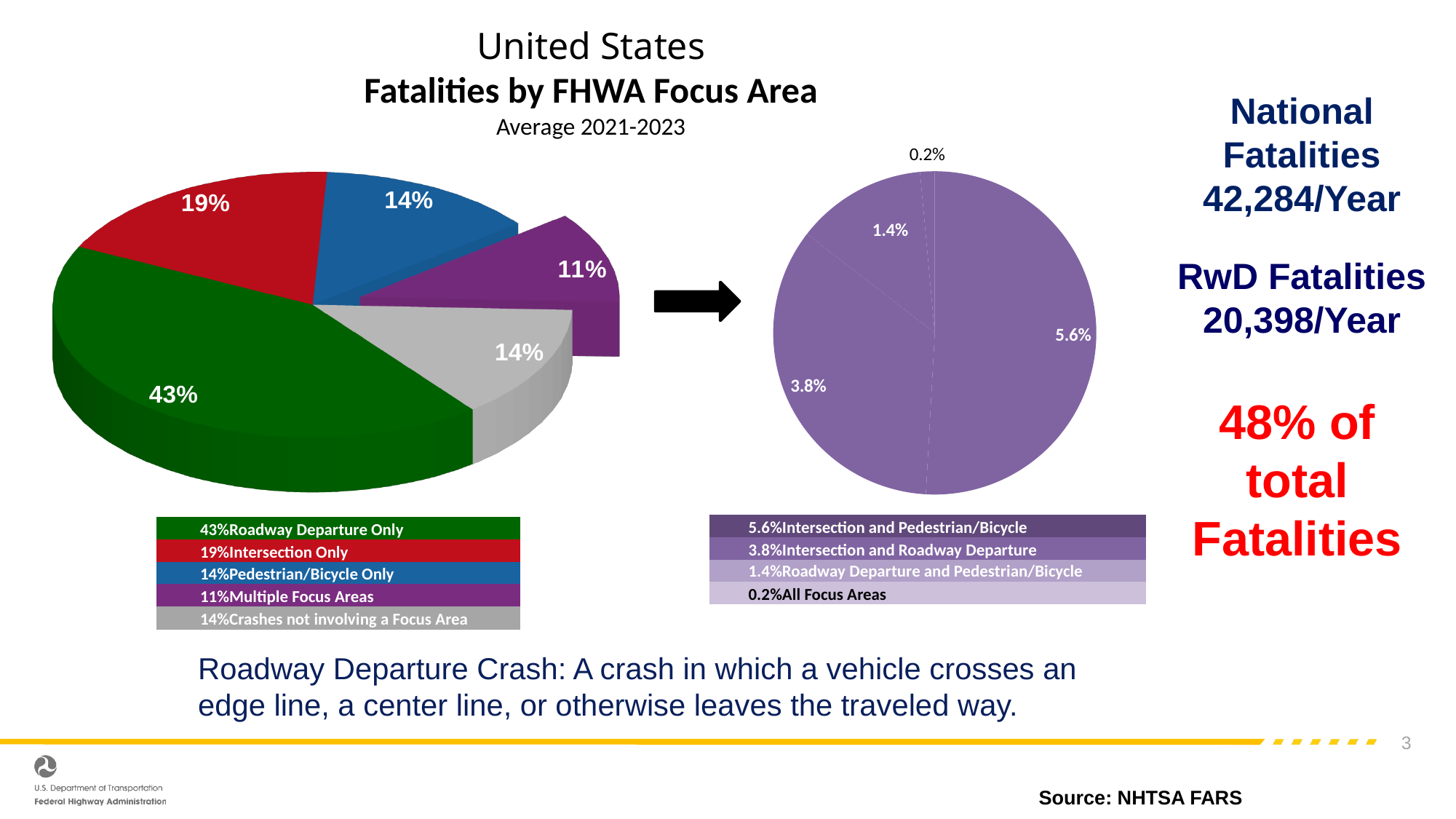
In the right pie chart, what share is Roadway Departure and Pedestrian/Bicycle? 1.4% In the right pie chart, what share is Intersection and Pedestrian/Bicycle? 5.6% In the left pie chart, which category has the smallest share? Multiple Focus Areas In the right pie chart, which category has the smallest share? All Focus Areas In the left pie chart, what share of fatalities is Intersection Only? 19% In the left pie chart, which category has the largest share? Roadway Departure Only In the left pie chart, how many categories are shown? 5 What type of chart is the left chart? Pie chart In the left pie chart, what is the difference between the Roadway Departure Only share and the Intersection Only share? 24% In the left pie chart, what share of fatalities is Multiple Focus Areas? 11% In the left pie chart, what share of fatalities is Roadway Departure Only? 43% In the right pie chart, which is larger: Intersection and Roadway Departure or Roadway Departure and Pedestrian/Bicycle? Intersection and Roadway Departure